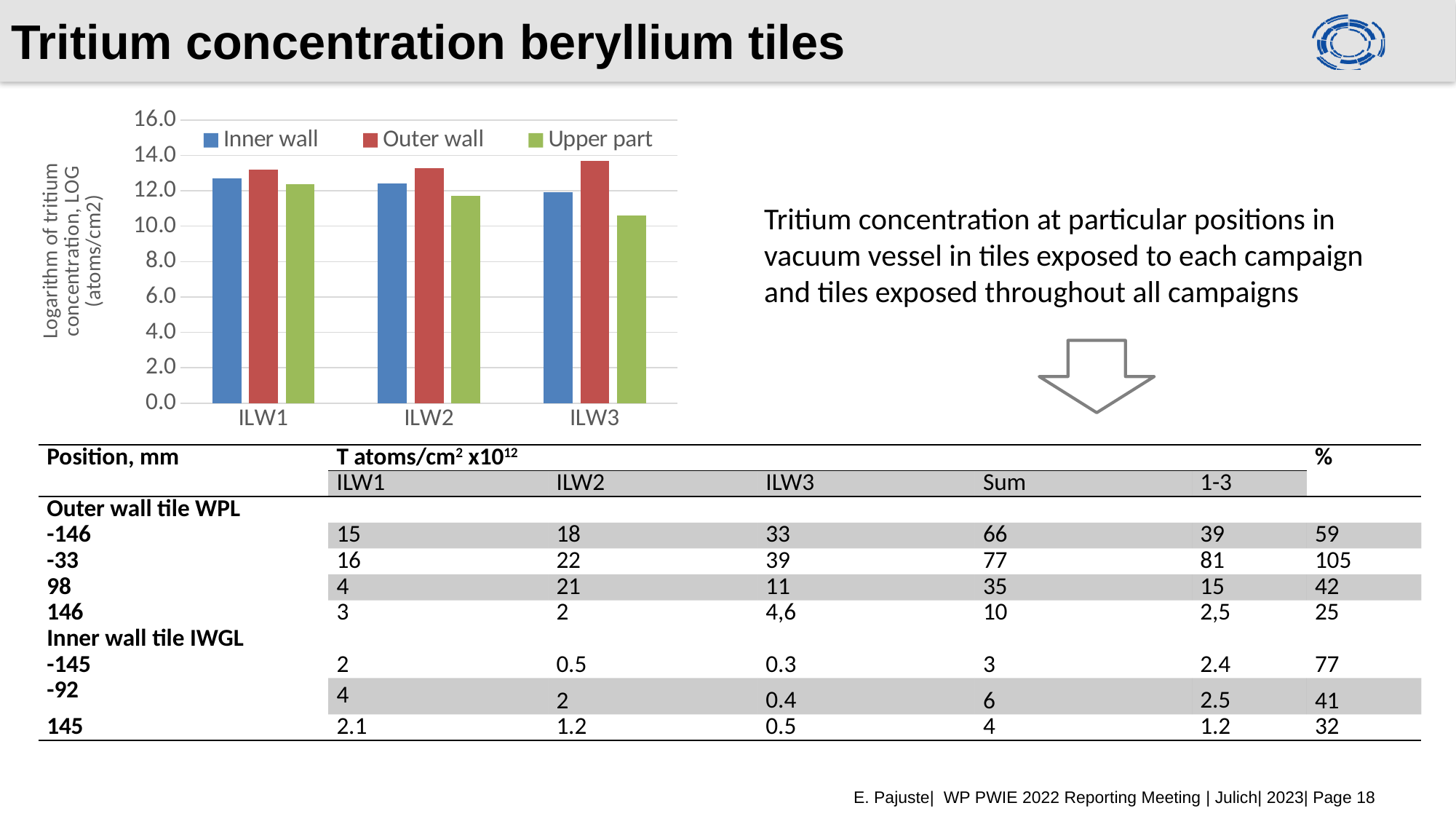
How many categories are shown on the x axis of the chart? 3 Is the Upper part value for ILW3 greater or less than 12.0? less Is the Upper part value for ILW3 greater or less than 10.0? greater What kind of chart is shown on the slide? bar chart What colour represents the Outer wall series in the chart? red For the Upper part series, which category has the highest value? ILW1 Do the Upper part values rise or fall from ILW1 to ILW3? fall For ILW2, which is larger: the Inner wall value or the Upper part value? Inner wall How many series does the chart legend list? 3 Which series has the highest value for ILW3? Outer wall Is the Outer wall value for ILW3 greater or less than 12.0? greater For the Upper part series, which category has the lowest value? ILW3